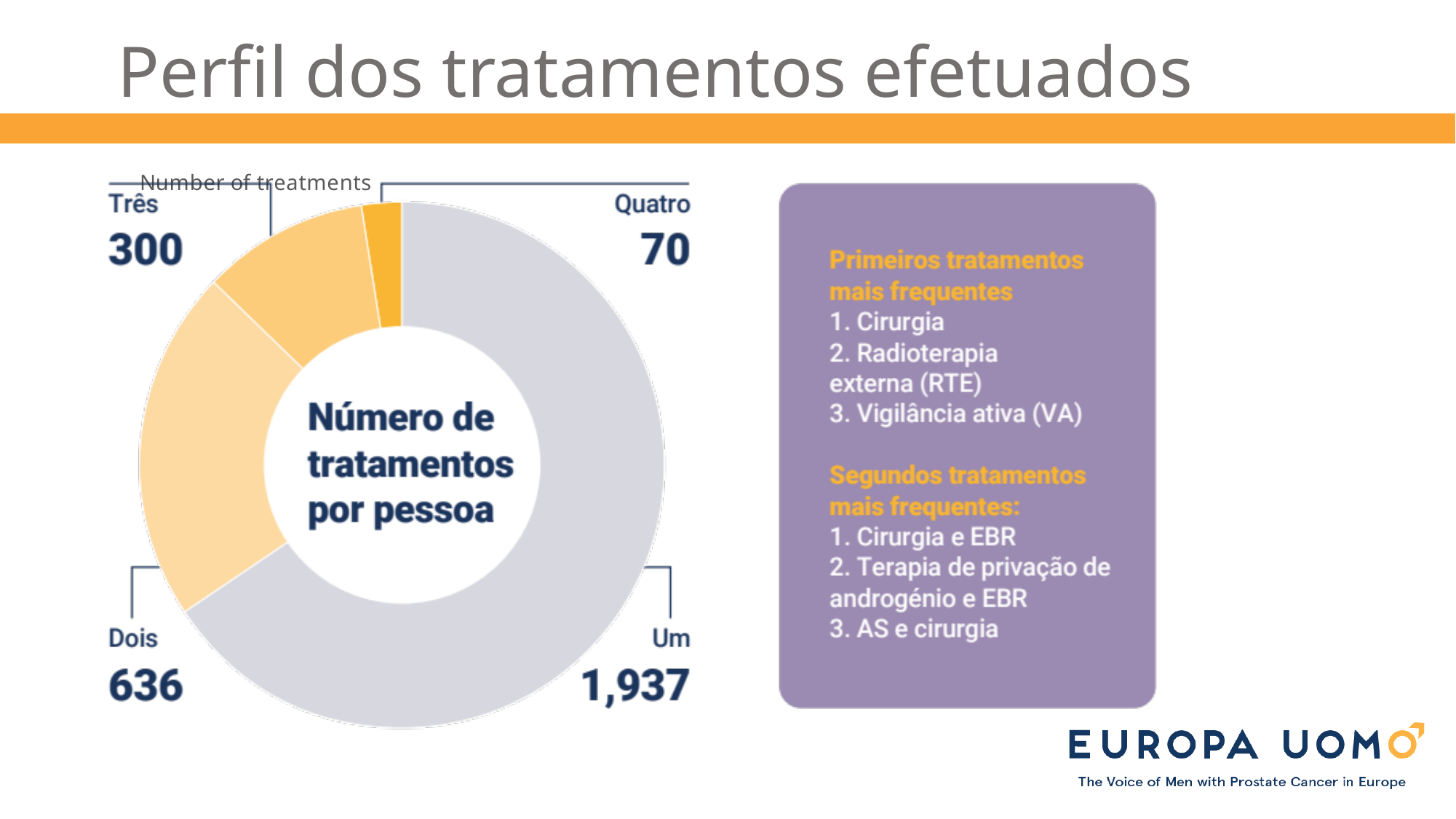
What is the difference between the values for 'Um' and 'Dois'? 1,301 What is the value for the 'Quatro' category? 70 Which category has the lowest value? Quatro What type of chart is shown on the slide? Pie chart (donut) What is the value for the 'Três' category? 300 What is the difference between the values for 'Três' and 'Quatro'? 230 Which is larger, the value for 'Dois' or the value for 'Três'? Dois How many categories does the donut chart show? 4 What is the value for the 'Dois' category? 636 What text is written in the centre of the donut chart? Número de tratamentos por pessoa What is the value for the 'Um' category? 1,937 Which category has the highest value? Um